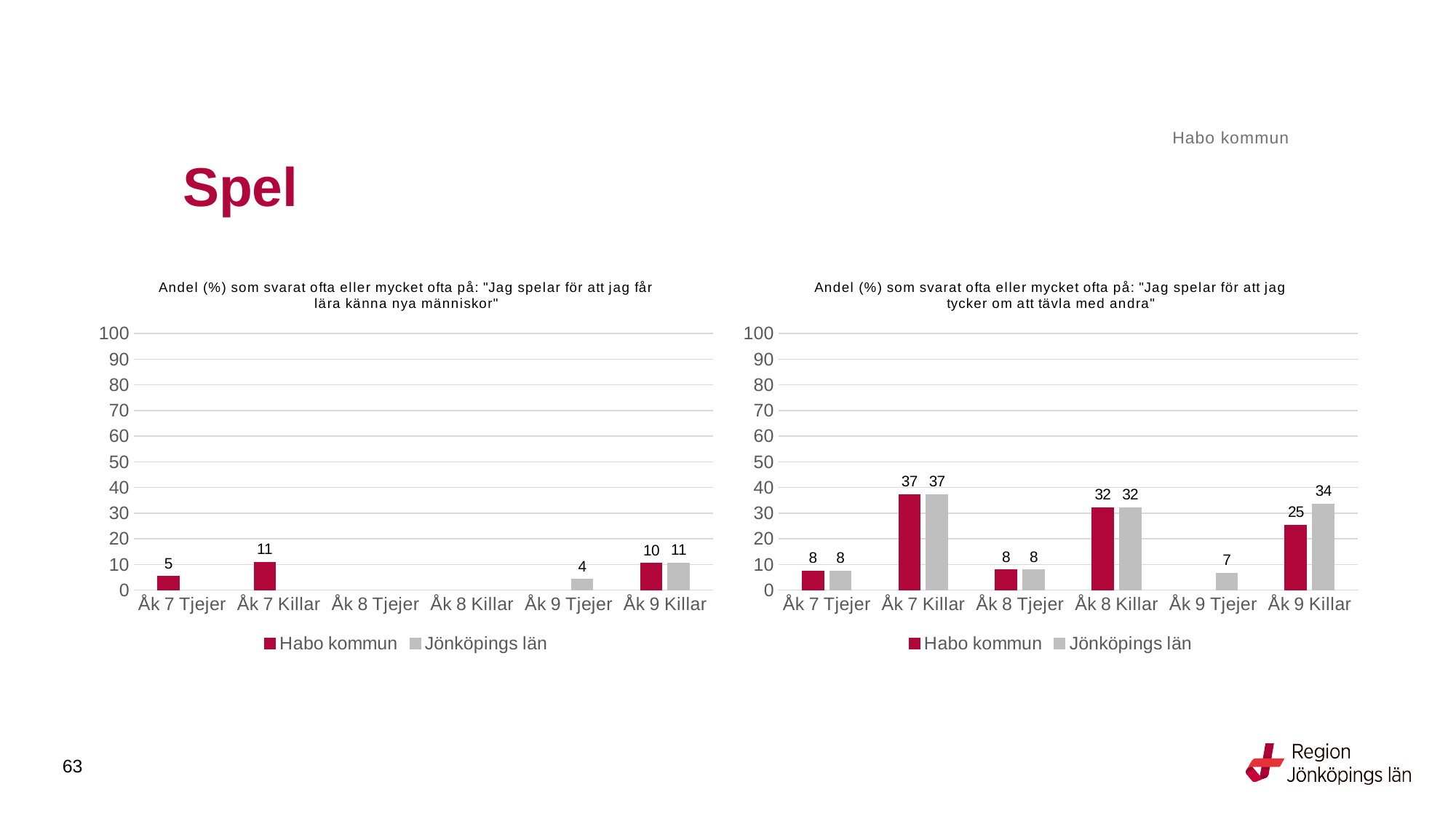
In the right chart, which is larger for Åk 8 Killar: Habo kommun or Jönköpings län? They are equal (32) In the right chart, what is the difference between Jönköpings län and Habo kommun for Åk 9 Killar? 9 How many series does the legend of the right chart list? 2 In the right chart, what is the value for Jönköpings län for Åk 9 Tjejer? 7 In the right chart, what is the value for Jönköpings län for Åk 9 Killar? 34 In the right chart, which category has the highest value for Habo kommun? Åk 7 Killar In the left chart, what is the value for Habo kommun for Åk 7 Killar? 11 How many categories are shown on the x axis of the left chart? 6 In the left chart, what is the value for Habo kommun for Åk 7 Tjejer? 5 In the left chart, what is the difference between Jönköpings län and Habo kommun for Åk 9 Killar? 1 What kind of chart is the right chart? Bar chart In the left chart, what is the value for Jönköpings län for Åk 9 Tjejer? 4